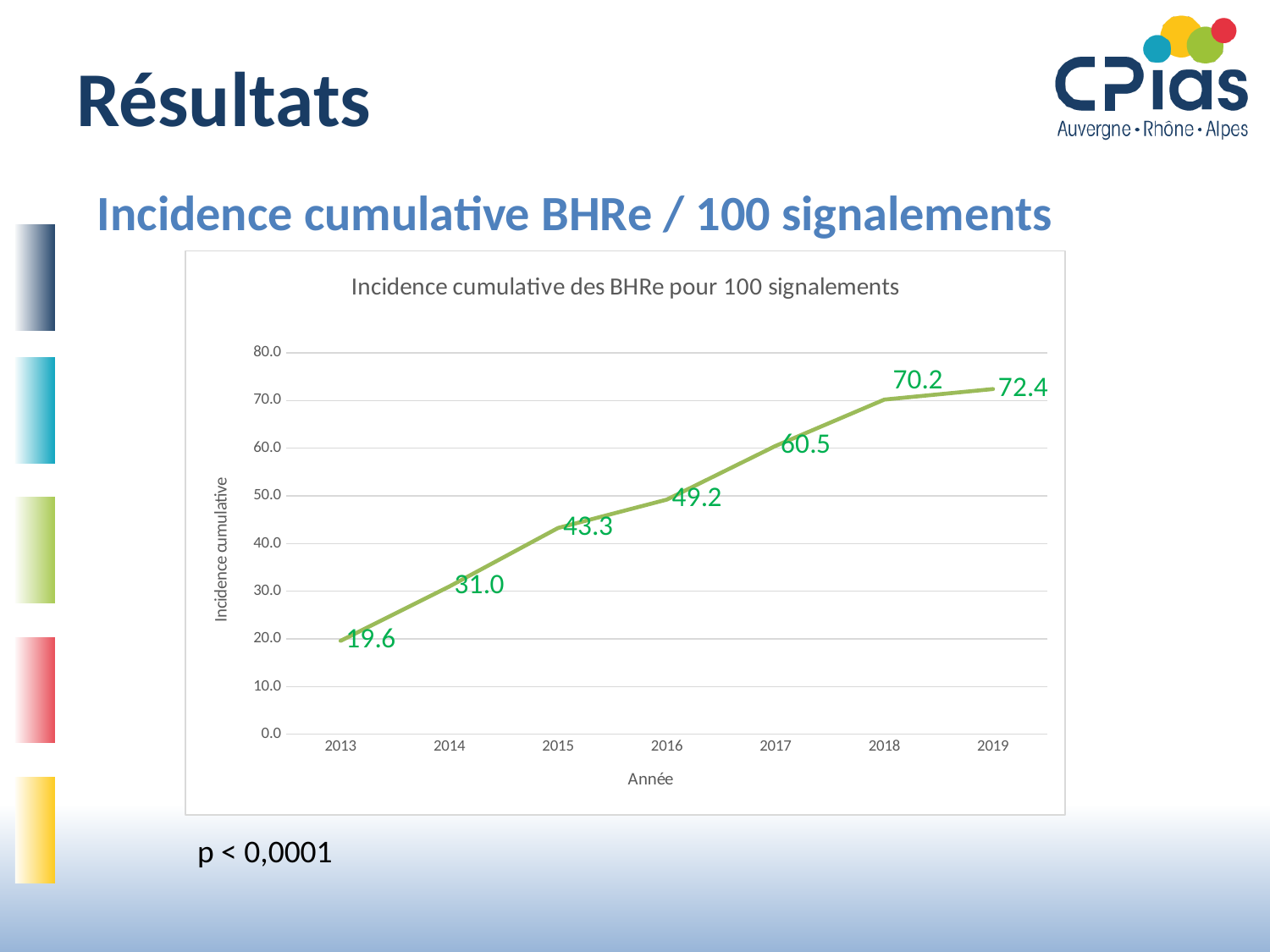
What is the cumulative incidence value for 2016? 49.2 Which year has the highest cumulative incidence? 2019 What kind of chart is shown? Line chart How many years are plotted on the x axis? 7 Which year has the lowest cumulative incidence? 2013 Which year has a larger value, 2015 or 2017? 2017 What is the difference between the values for 2017 and 2016? 11.3 What is the cumulative incidence value for 2013? 19.6 Is the value for 2018 greater or less than 60.0? greater What is the cumulative incidence value for 2019? 72.4 Do the values rise or fall from 2013 to 2019? Rise What is the difference between the values for 2019 and 2013? 52.8